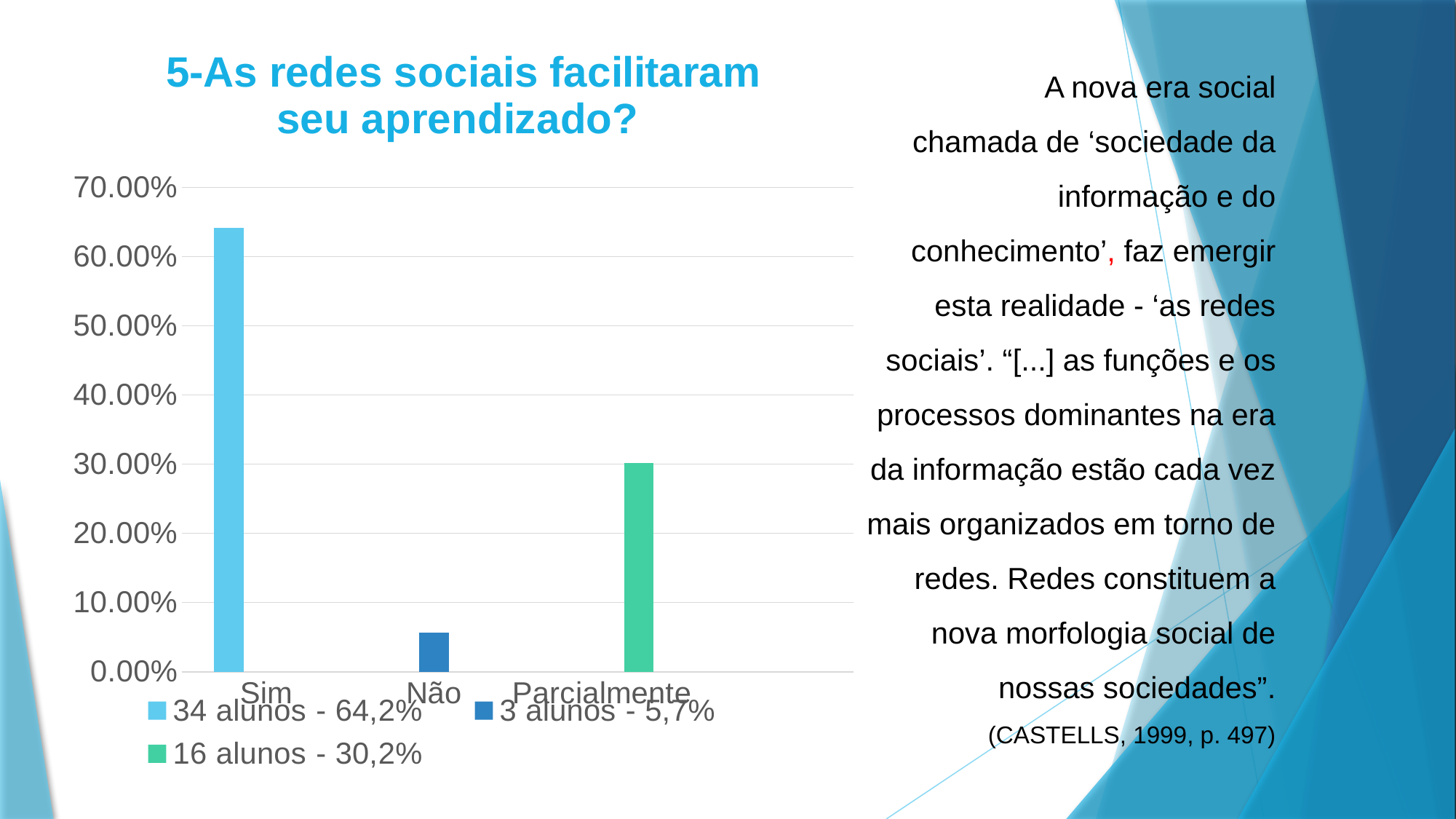
How many entries does the chart's legend list? 3 Which is larger, the value for 'Parcialmente' or the value for 'Não'? Parcialmente Which category has the highest bar in the chart? Sim How many categories are shown on the x axis of the chart? 3 What is the title of the chart? 5-As redes sociais facilitaram seu aprendizado? According to the legend, what percentage corresponds to the 'Parcialmente' bar? 30,2% Is the value for 'Sim' greater or less than 60.00%? greater According to the legend, how many students answered 'Não'? 3 alunos Is the value for 'Não' greater or less than 10.00%? less According to the legend, what percentage corresponds to the 'Sim' bar? 64,2% Which category has the lowest bar in the chart? Não What kind of chart is shown on the slide? bar chart